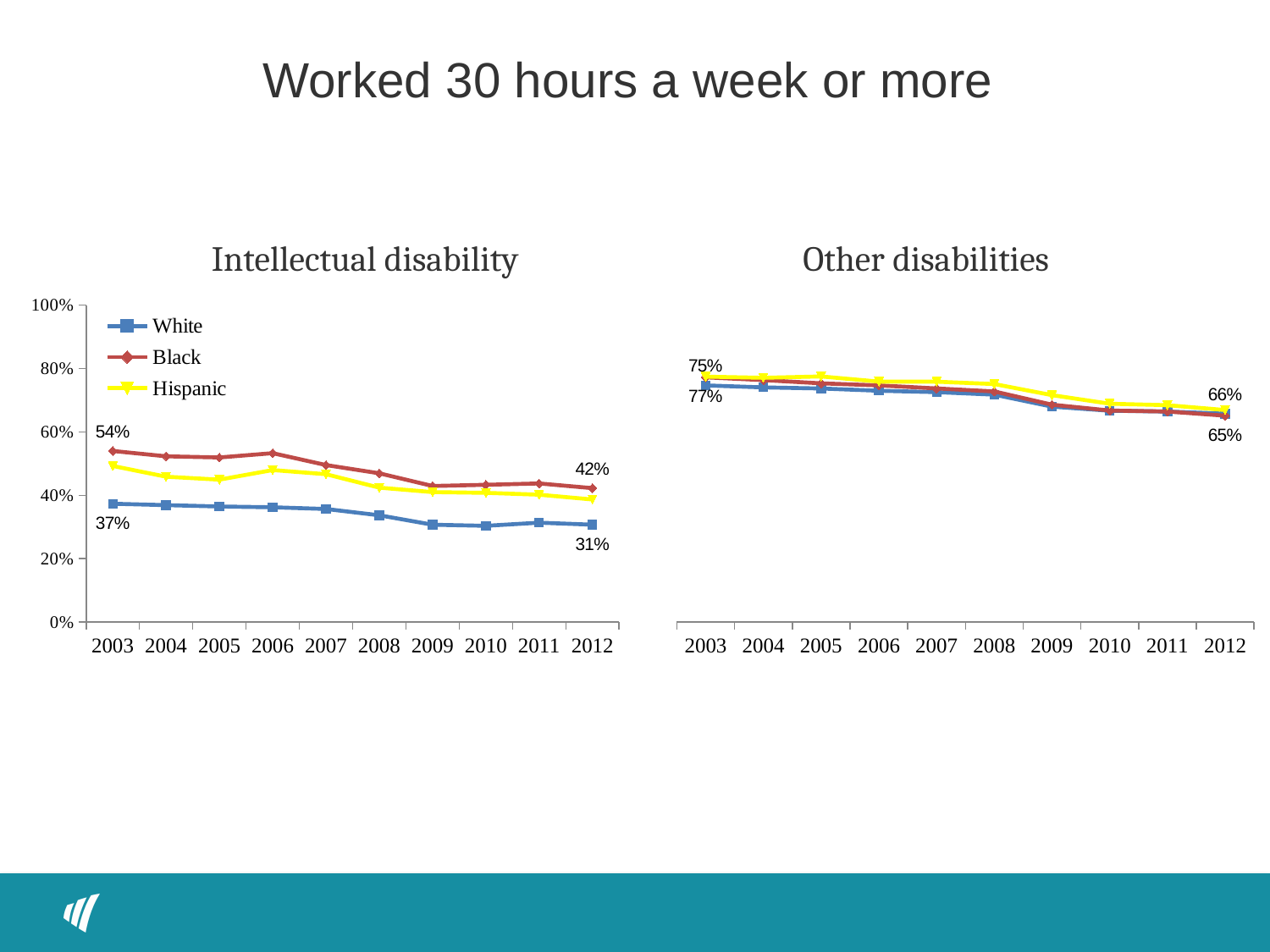
What kind of chart is the 'Intellectual disability' chart? Line chart In the 'Intellectual disability' chart, what is the value for Black in 2003? 54% In the 'Intellectual disability' chart, what is the difference between the Black and White values in 2003? 17 percentage points In the 'Other disabilities' chart, do the values generally rise or fall from 2003 to 2012? Fall In the 'Intellectual disability' chart, is the value for Hispanic in 2003 greater or less than 40%? greater How many years are shown on the x axis of the 'Other disabilities' chart? 10 In the 'Intellectual disability' chart, what is the value for Black in 2012? 42% In the 'Intellectual disability' chart, which series has the highest value in 2012? Black In the 'Intellectual disability' chart, by how many percentage points did the Black value fall from 2003 to 2012? 12 percentage points In the 'Intellectual disability' chart, what is the value for White in 2003? 37% In the 'Intellectual disability' chart, what is the value for White in 2012? 31% How many series does the legend of the 'Intellectual disability' chart list? 3